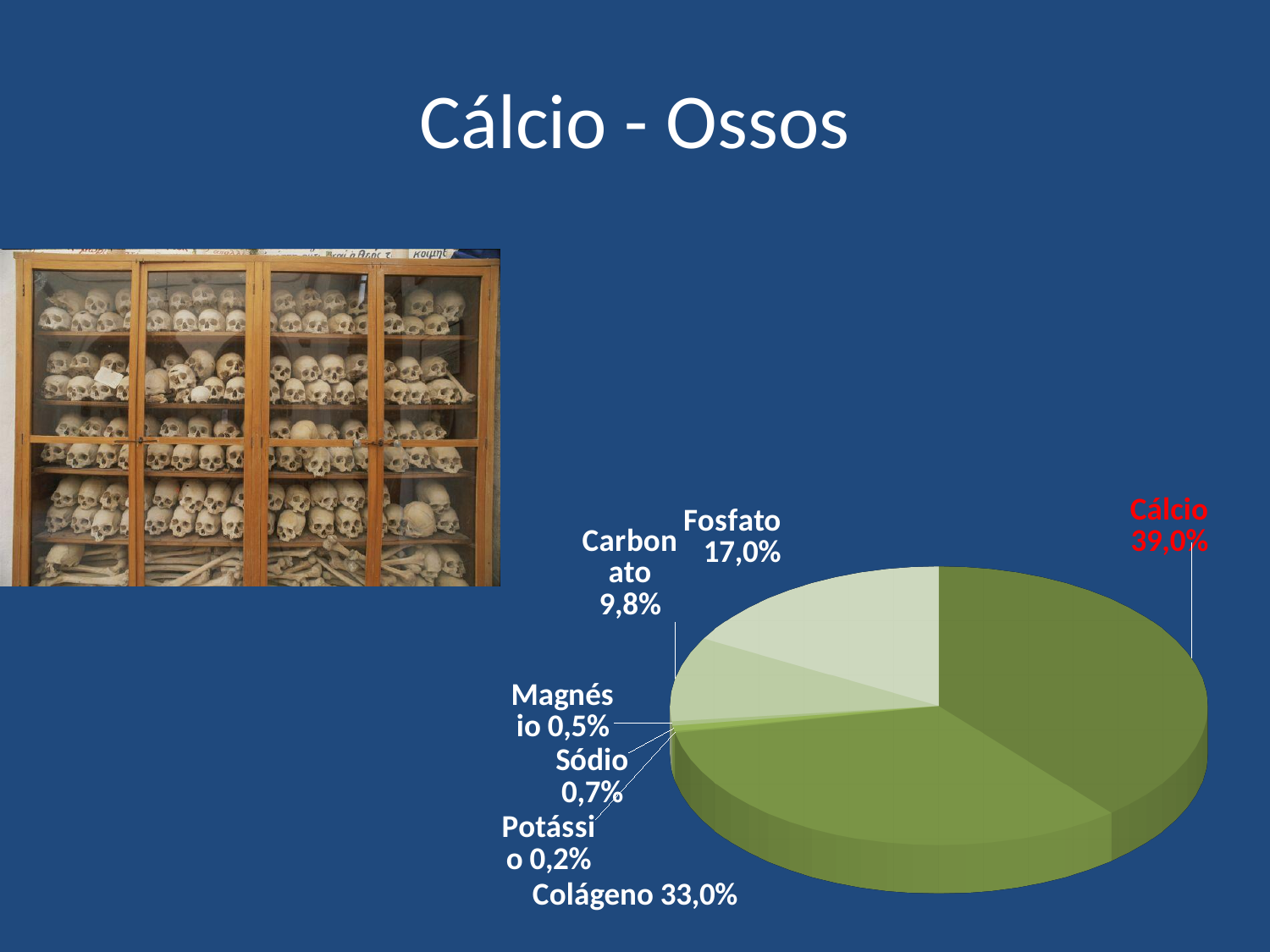
What is the difference between the Cálcio and Colágeno percentages? 6,0% How many slices does the pie chart have? 7 What is the title of the slide containing the pie chart? Cálcio - Ossos What percentage does the Cálcio slice show? 39,0% Which is larger, the Sódio slice or the Magnésio slice? Sódio Which component has the smallest slice of the pie? Potássio Which component has the largest slice of the pie? Cálcio What percentage does the Colágeno slice show? 33,0% What percentage does the Magnésio slice show? 0,5% What percentage does the Fosfato slice show? 17,0% What kind of chart is shown on the slide? Pie chart What percentage does the Carbonato slice show? 9,8%